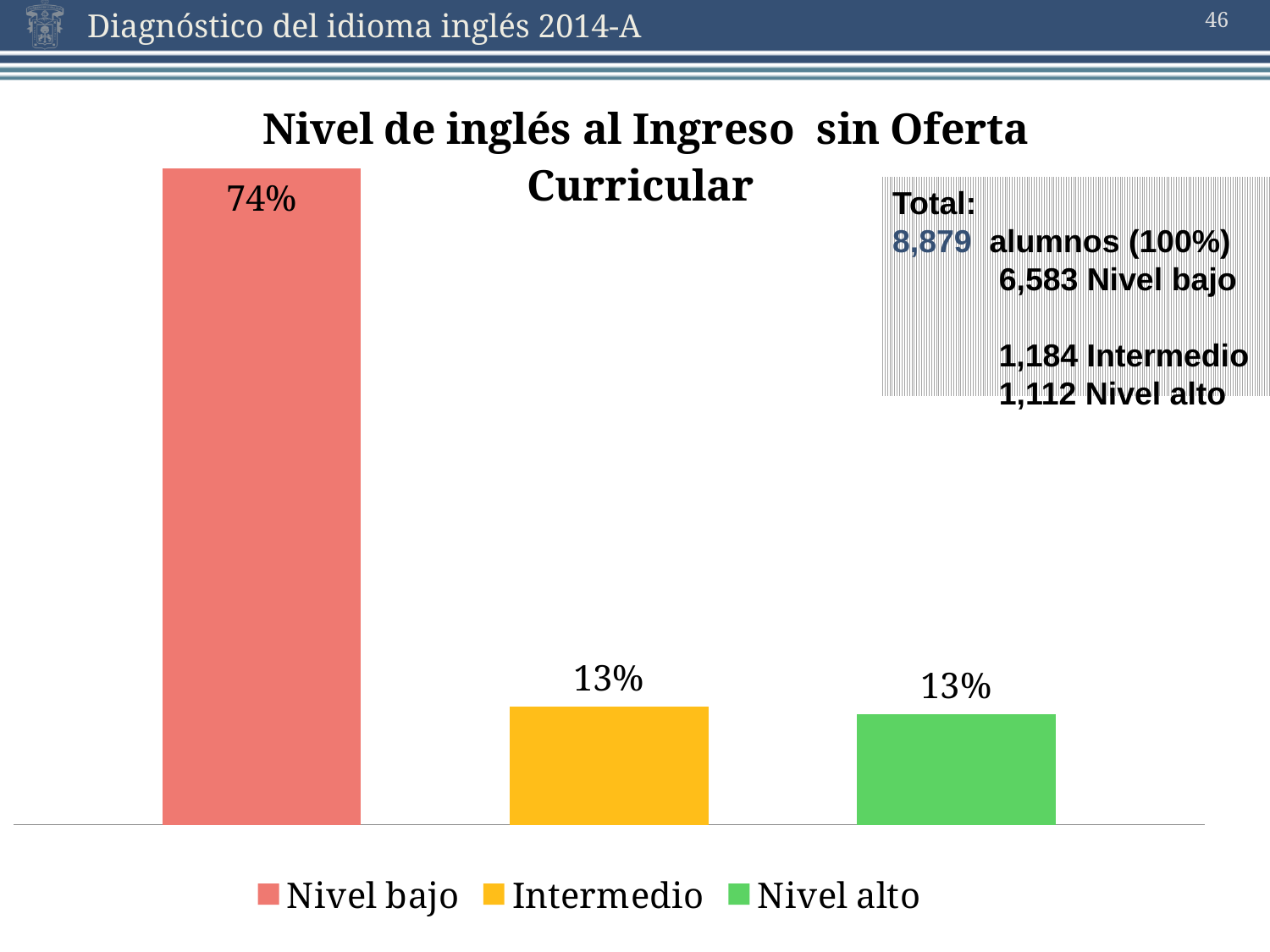
What kind of chart is shown on the slide? Bar chart What colour is the bar for Intermedio? Yellow What percentage is shown for Nivel alto? 13% What is the difference in percentage points between Nivel bajo and Intermedio? 61 What percentage is shown for Intermedio? 13% Which is larger, the value for Nivel bajo or the value for Nivel alto? Nivel bajo Which category has the highest percentage? Nivel bajo How many categories are plotted in the chart? 3 How many entries does the legend list? 3 According to the text box, how many students are in Nivel bajo? 6,583 What percentage is shown for Nivel bajo? 74% What is the title of the chart? Nivel de inglés al Ingreso sin Oferta Curricular